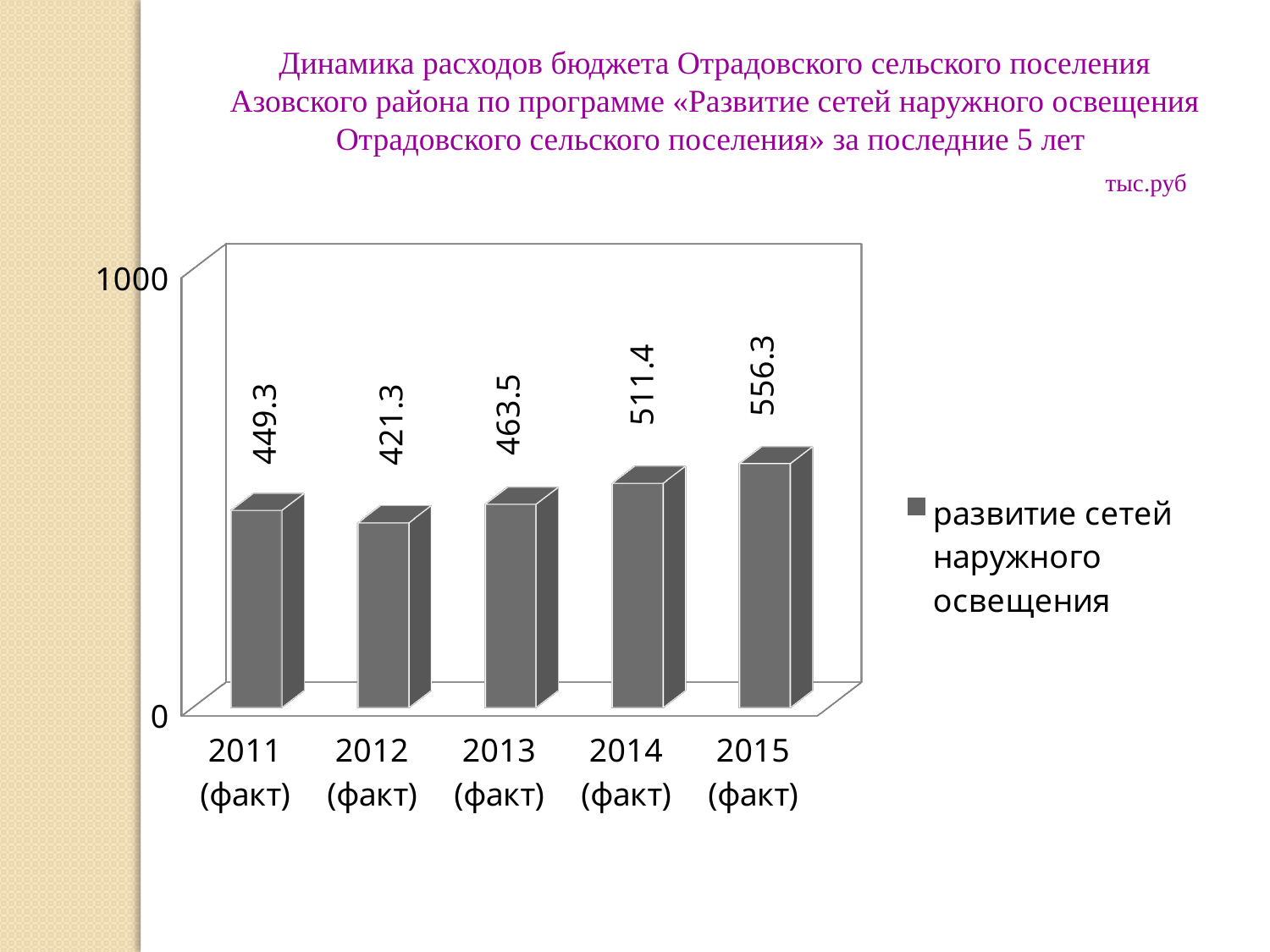
Which year has the highest value? 2015 (факт) What is the difference between the values for 2011 (факт) and 2012 (факт)? 28 What is the value for 2013 (факт)? 463.5 How many years are shown on the x axis? 5 What series name does the legend show? развитие сетей наружного освещения What is the difference between the values for 2015 (факт) and 2014 (факт)? 44.9 Which year has the lowest value? 2012 (факт) Is the value for 2014 (факт) greater or less than 1000? less What is the value for 2015 (факт)? 556.3 What kind of chart is shown on the slide? bar chart Which is larger, the value for 2013 (факт) or the value for 2011 (факт)? 2013 (факт) What is the value for 2011 (факт)? 449.3